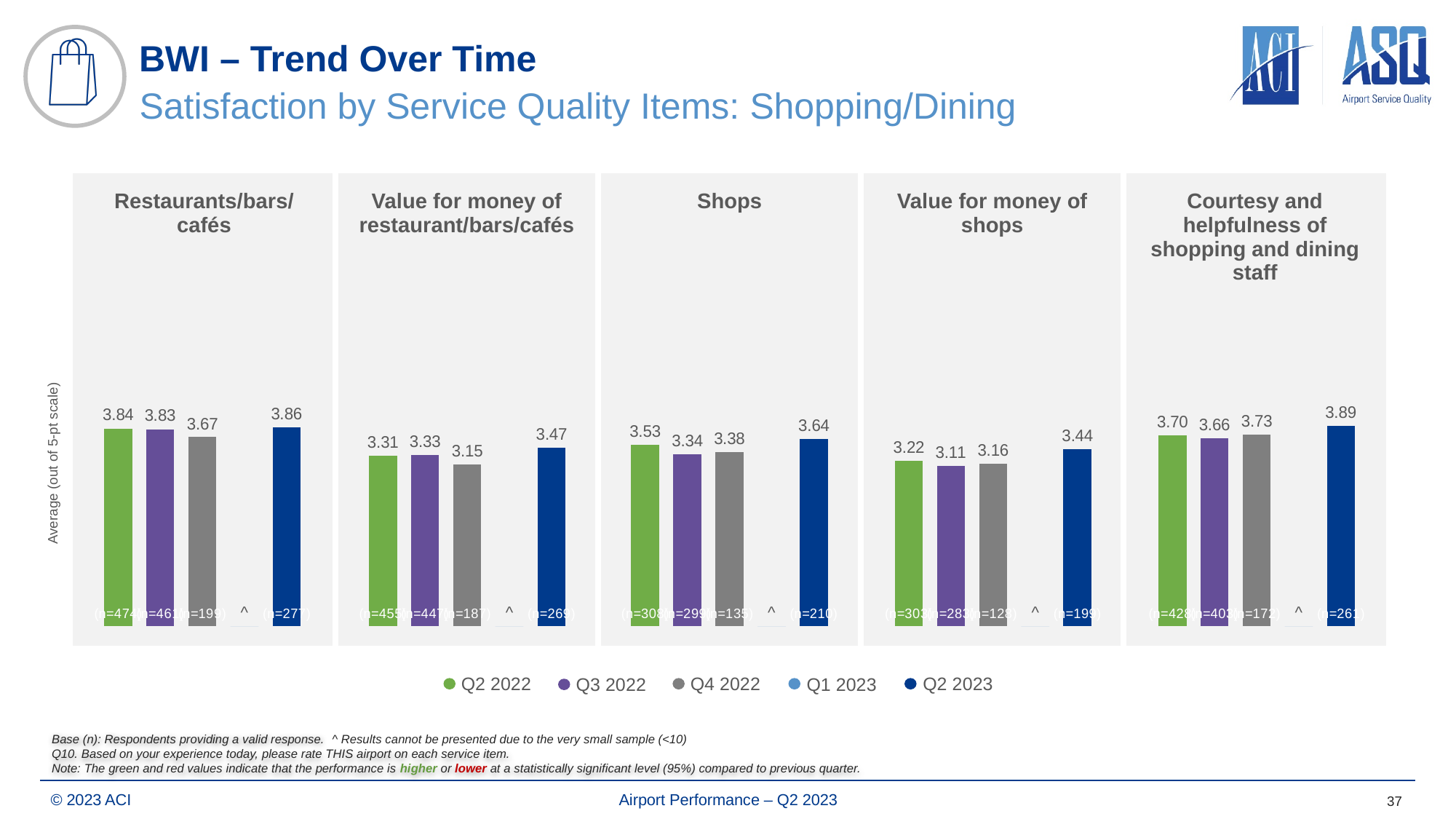
In the Value for money of shops chart, what is the difference between the Q2 2023 value and the Q4 2022 value? 0.28 What kind of chart is used in the Restaurants/bars/cafés panel? Bar chart In the Value for money of shops chart, what is the value for Q3 2022? 3.11 In the Courtesy and helpfulness of shopping and dining staff chart, what is the value for Q4 2022? 3.73 In the Courtesy and helpfulness of shopping and dining staff chart, which is larger, the Q2 2022 value or the Q3 2022 value? Q2 2022 Which quarter's results are not presented in the charts due to a very small sample? Q1 2023 In the Shops chart, what is the value for Q2 2023? 3.64 In the Shops chart, what is the difference between the Q2 2023 value and the Q2 2022 value? 0.11 In the Value for money of restaurant/bars/cafés chart, which quarter has the highest value? Q2 2023 In the Restaurants/bars/cafés chart, which quarter has the lowest value? Q4 2022 How many series does the legend list? 5 In the Shops chart, which is larger, the Q3 2022 value or the Q4 2022 value? Q4 2022